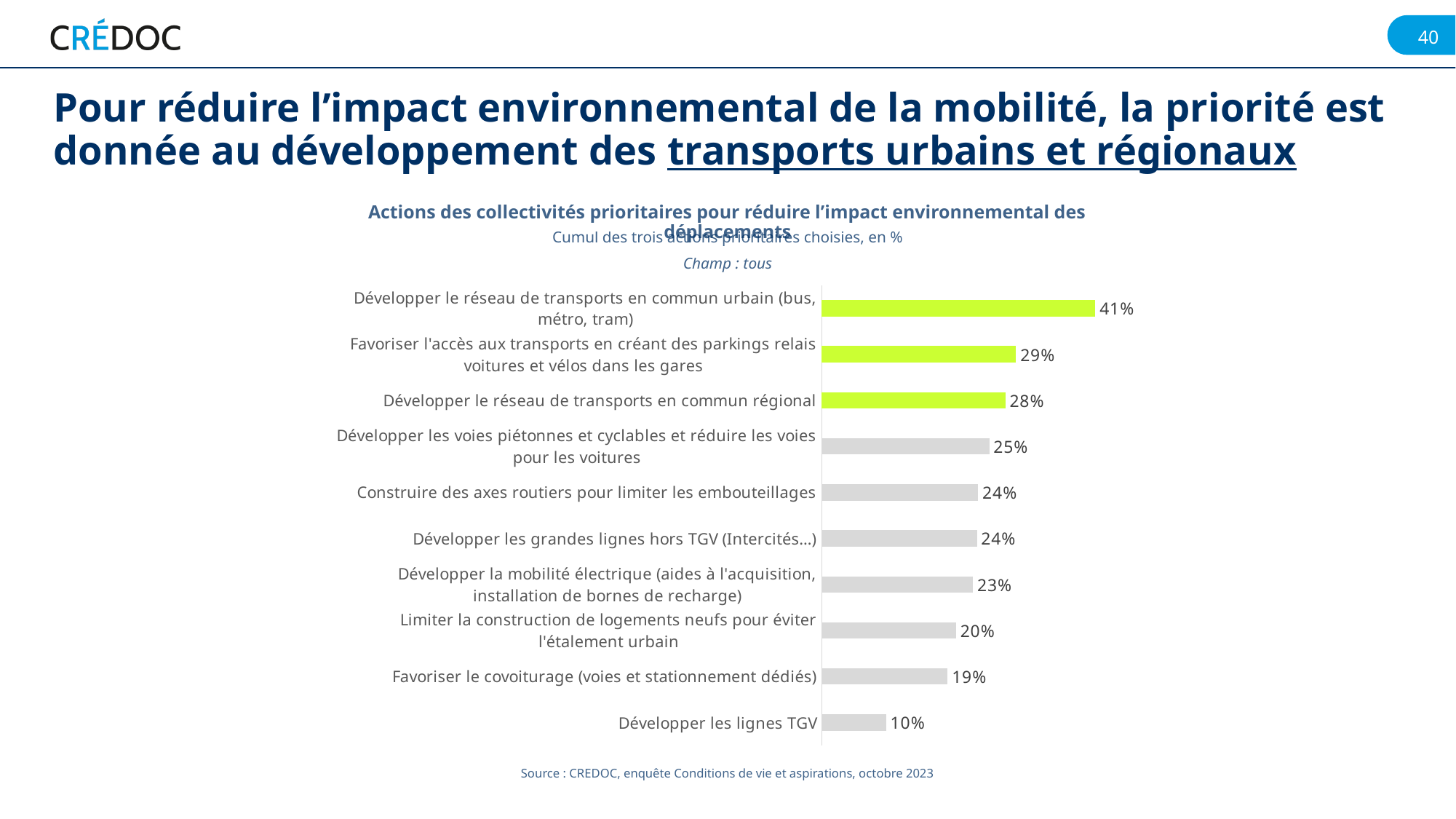
What is the difference between the values for "Développer le réseau de transports en commun urbain (bus, métro, tram)" and "Développer le réseau de transports en commun régional"? 13 percentage points What is the value for "Favoriser le covoiturage (voies et stationnement dédiés)"? 19% Which is larger: the value for "Favoriser l'accès aux transports en créant des parkings relais voitures et vélos dans les gares" or for "Développer les voies piétonnes et cyclables et réduire les voies pour les voitures"? Favoriser l'accès aux transports en créant des parkings relais voitures et vélos dans les gares How many bars are highlighted in green rather than grey? 3 What is the value for "Développer la mobilité électrique (aides à l'acquisition, installation de bornes de recharge)"? 23% Which category has the highest value? Développer le réseau de transports en commun urbain (bus, métro, tram) What is the value for "Développer le réseau de transports en commun urbain (bus, métro, tram)"? 41% What is the source cited below the chart? CREDOC, enquête Conditions de vie et aspirations, octobre 2023 What kind of chart is shown on the slide? Bar chart Which category has the lowest value? Développer les lignes TGV How many categories are shown in the chart? 10 What is the difference between the values for "Favoriser le covoiturage (voies et stationnement dédiés)" and "Développer les lignes TGV"? 9 percentage points